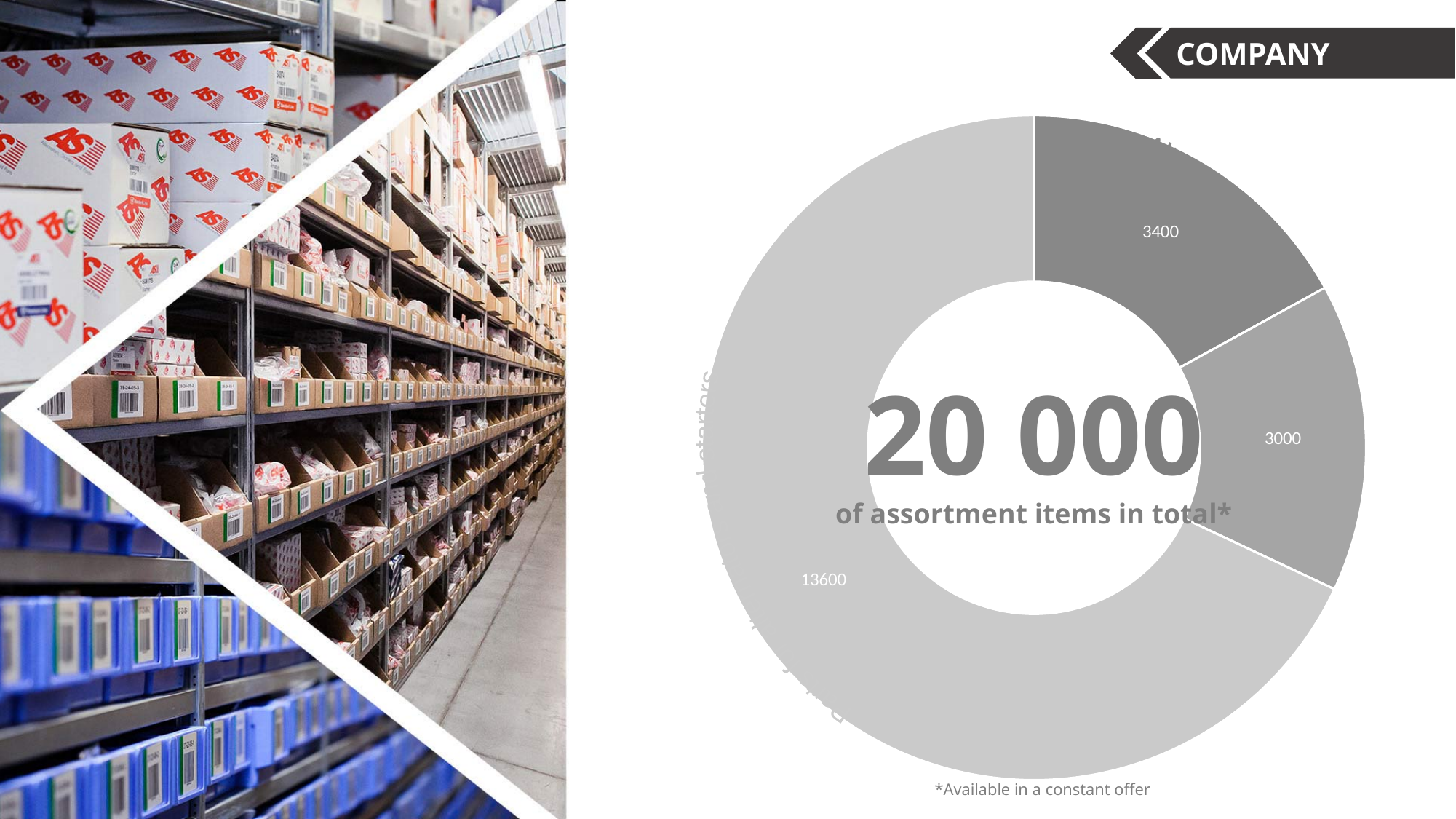
How many slices does the donut chart have? 3 What does the footnote below the chart say? *Available in a constant offer What is the largest value among the slices of the donut chart? 13600 What share of the total do the 13600 items represent? 68% What kind of chart is shown on the slide? Donut (pie) chart What value is shown on the dark grey slice at the top right of the donut chart? 3400 What is the difference between the largest slice (13600) and the smallest slice (3000)? 10600 What is the total number of assortment items shown in the centre of the donut chart? 20 000 What is the smallest value among the slices of the donut chart? 3000 What is the difference between the 3400 slice and the 3000 slice? 400 What value is shown on the largest (light grey) slice of the donut chart? 13600 What value is shown on the medium grey slice on the right side of the donut chart? 3000